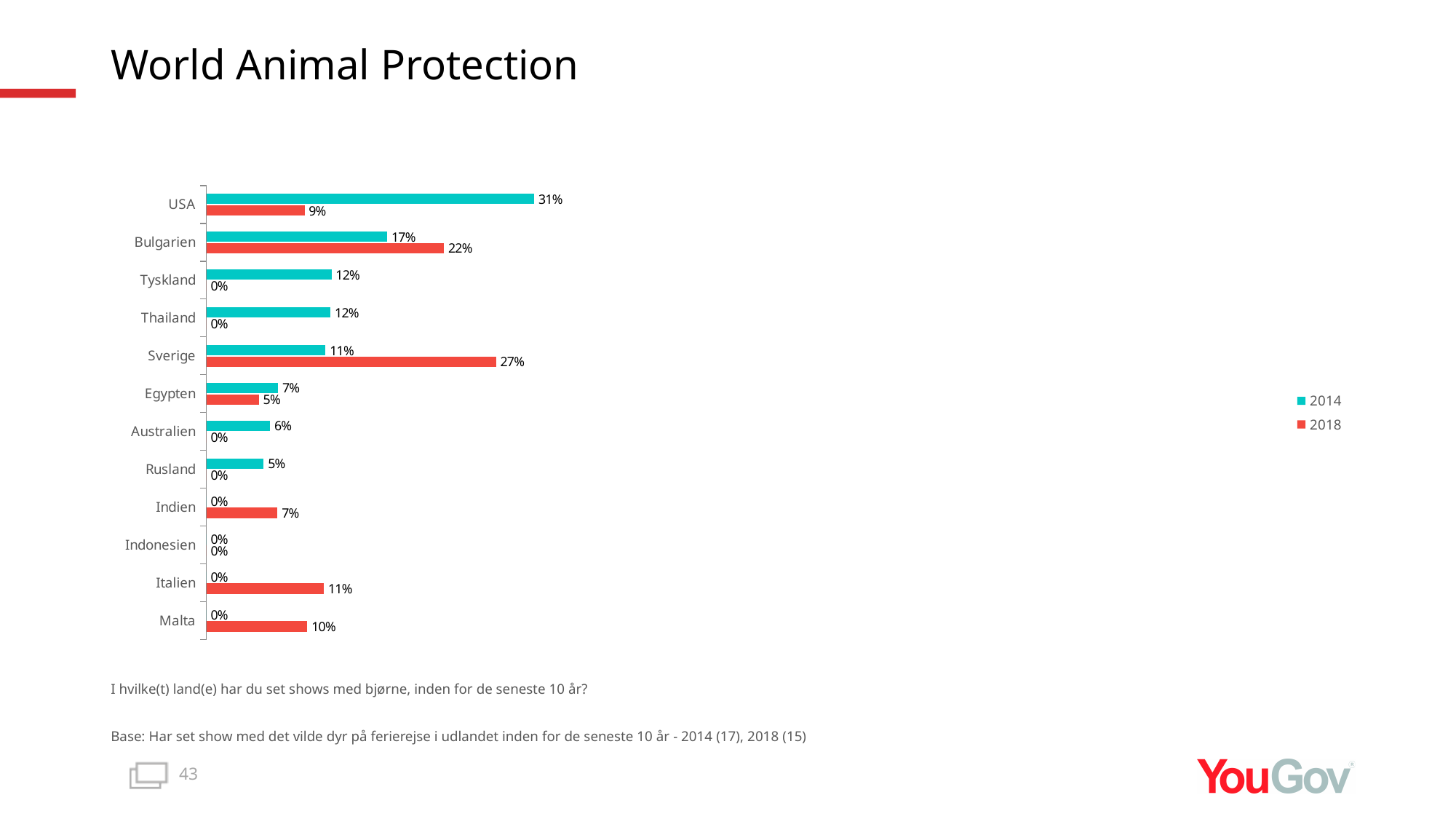
What kind of chart is shown on the slide? Bar chart What is the 2018 value for Sverige? 27% What is the 2018 value for Bulgarien? 22% Which country has the highest 2018 value? Sverige What is the difference between the 2018 and 2014 values for Sverige? 16% What is the 2014 value for USA? 31% Which colour represents the 2018 series? Red What is the difference between the 2014 and 2018 values for USA? 22% Which is larger for Bulgarien, the 2014 value or the 2018 value? 2018 How many series does the legend list? 2 How many countries are shown on the chart? 12 Which country has the highest 2014 value? USA